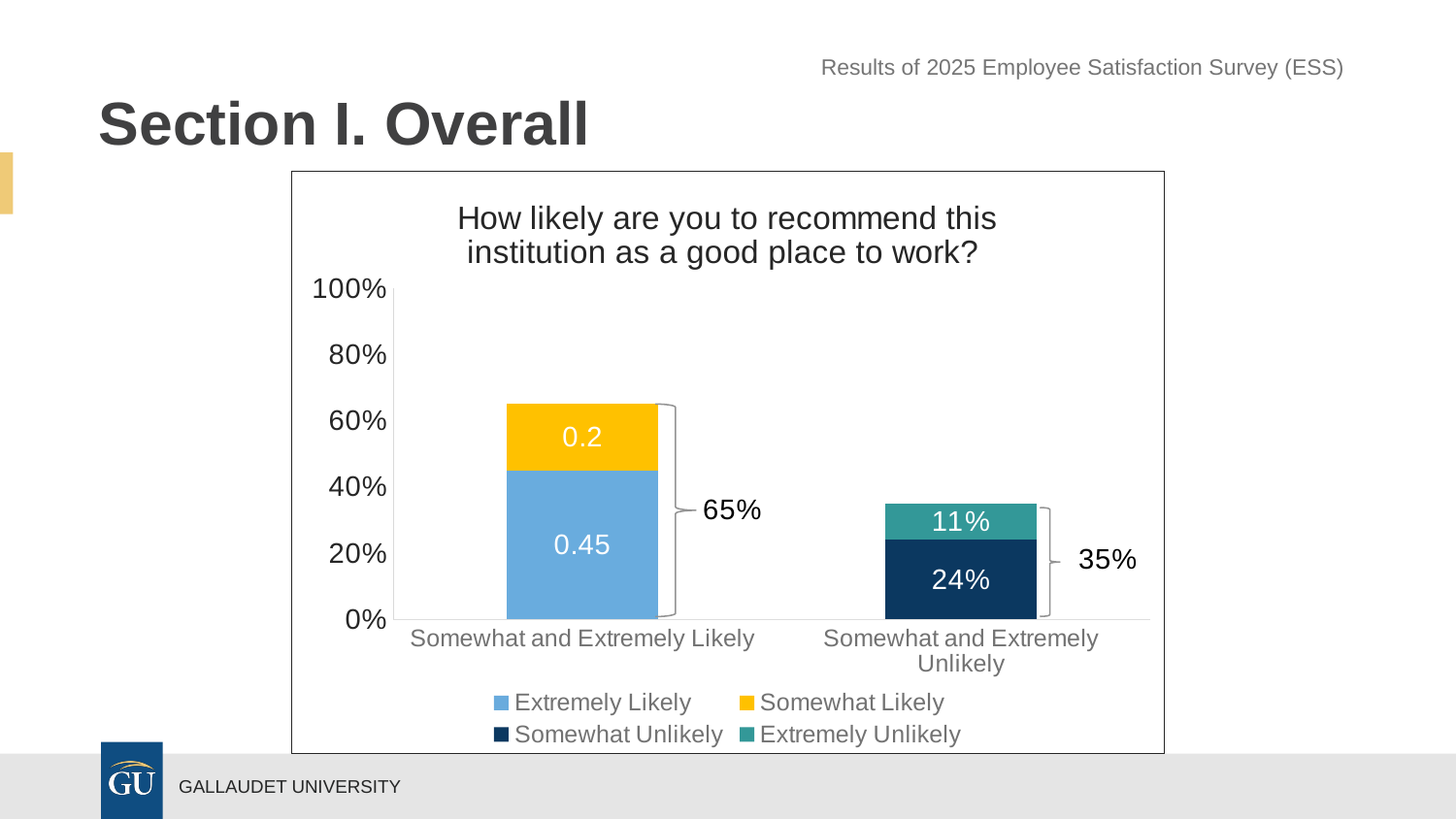
How many categories are shown on the x axis? 2 What is the difference between the Somewhat Unlikely and Extremely Unlikely values? 13% What is the data label for the Extremely Likely segment? 0.45 How many series does the legend list? 4 What is the data label for the Somewhat Likely segment? 0.2 What is the data label for the Somewhat Unlikely segment? 24% What is the total shown for the Somewhat and Extremely Likely bar? 65% What is the title of the chart? How likely are you to recommend this institution as a good place to work? What is the data label for the Extremely Unlikely segment? 11% Which bar is taller, Somewhat and Extremely Likely or Somewhat and Extremely Unlikely? Somewhat and Extremely Likely What is the total shown for the Somewhat and Extremely Unlikely bar? 35% What type of chart is shown on the slide? stacked bar chart